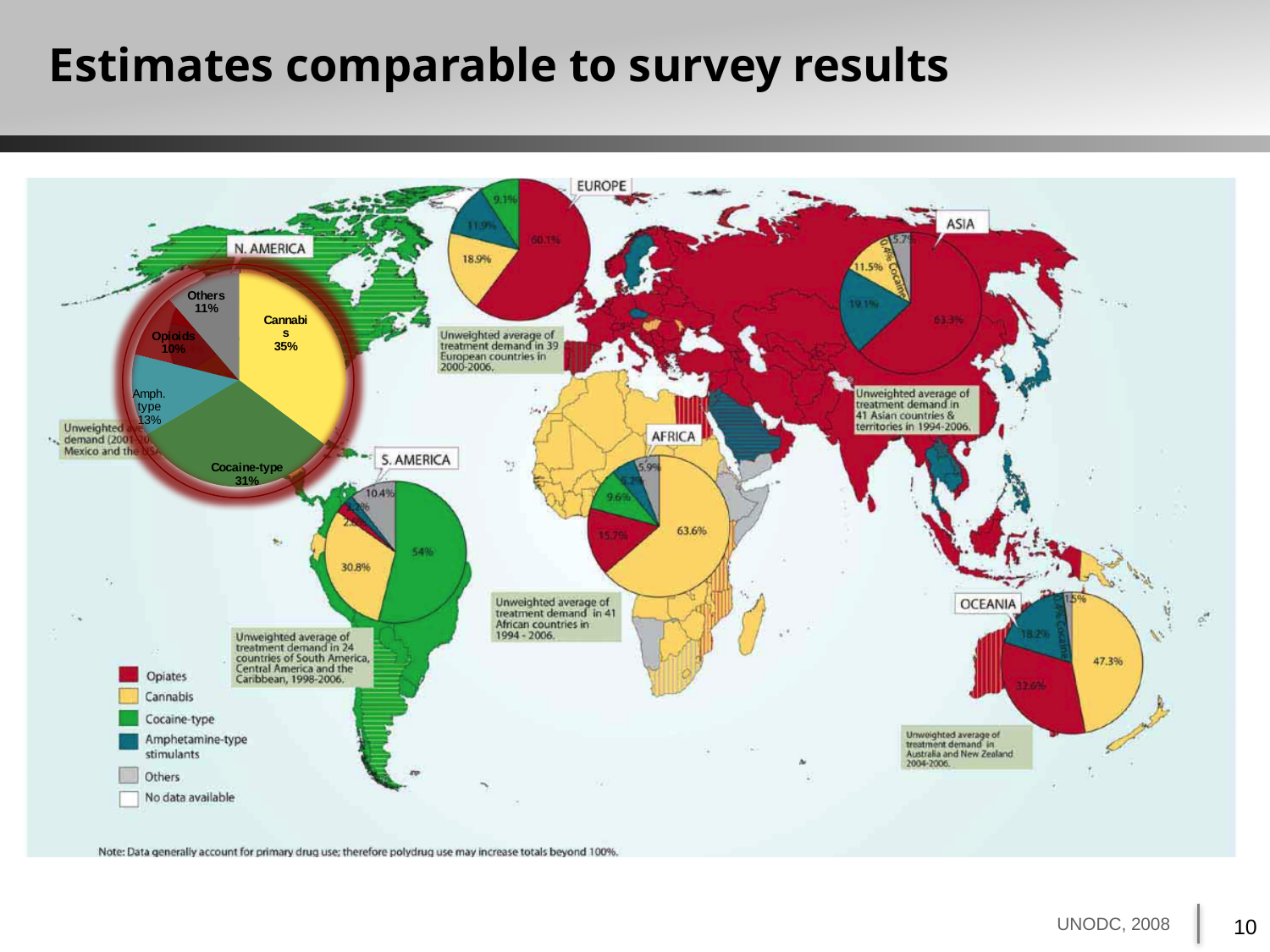
What type of chart is used for N. America? Pie chart In the N. America pie chart, what share is Opioids? 10% In the N. America pie chart, which category has the smallest share? Opioids In the N. America pie chart, what is the difference between the Cannabis and Cocaine-type shares? 4% In the N. America pie chart, what share is Amph. type? 13% In the N. America pie chart, which category has the largest share? Cannabis In the N. America pie chart, which is larger, Amph. type or Others? Amph. type In the N. America pie chart, what share is Cannabis? 35% In the Oceania pie chart, what is the largest share shown? 47.3% How many categories does the N. America pie chart show? 5 In the N. America pie chart, what share is Others? 11% In the N. America pie chart, what share is Cocaine-type? 31%